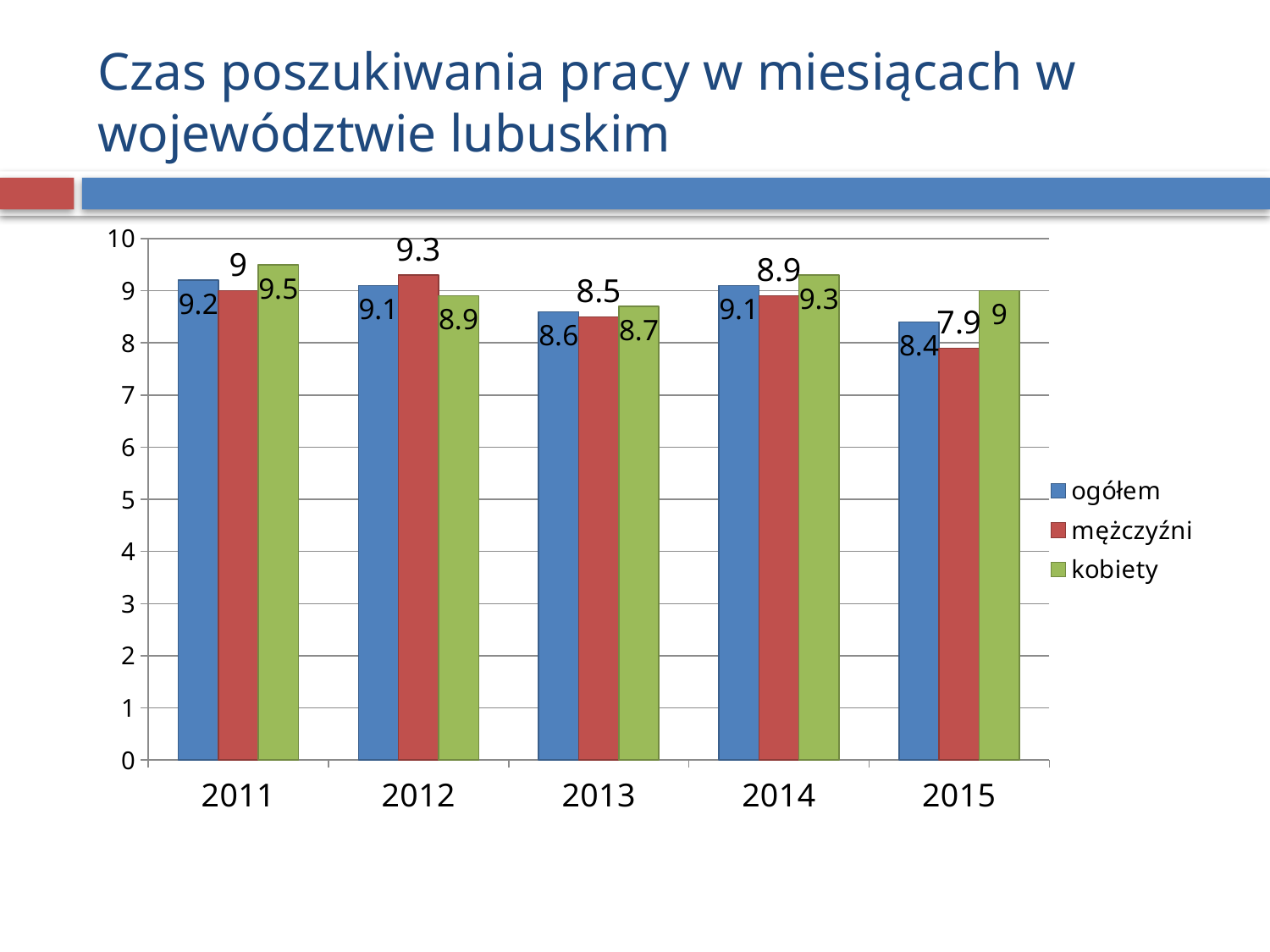
What is the value for mężczyźni in 2015? 7.9 Which is larger in 2012, the value for mężczyźni or the value for kobiety? mężczyźni Does the value for ogółem rise or fall from 2011 to 2015? fall Which series is shown in green in the legend? kobiety What is the value for ogółem in 2013? 8.6 How many years are shown on the x axis? 5 What is the difference between the kobiety and mężczyźni values in 2015? 1.1 In which year is the value for kobiety the highest? 2011 How many series does the legend list? 3 What is the value for kobiety in 2011? 9.5 What kind of chart is shown on the slide? bar chart In which year is the value for mężczyźni the lowest? 2015